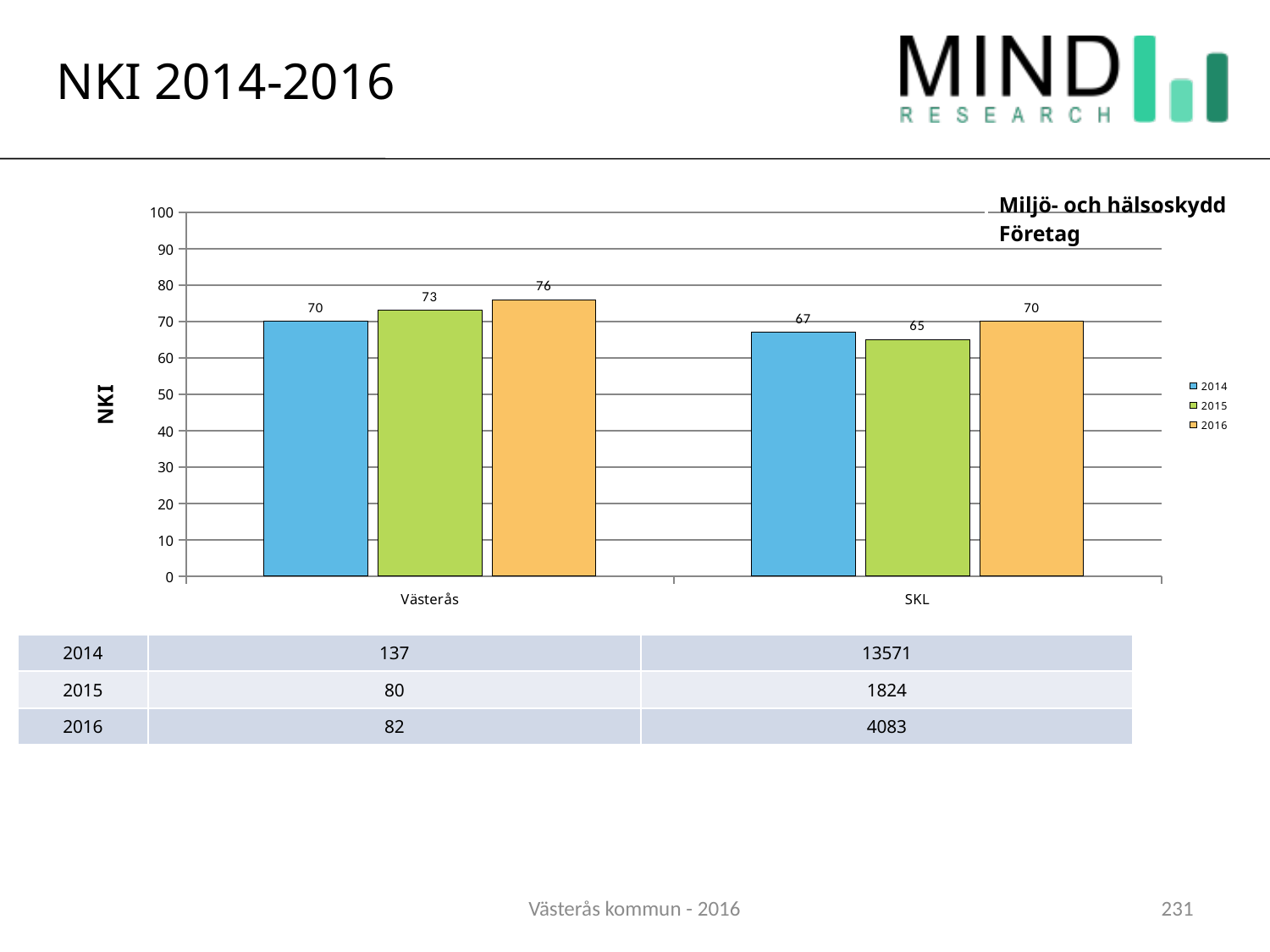
What is the label on the y axis of the chart? NKI Which is larger, the 2015 NKI value for Västerås or for SKL? Västerås What is the NKI value for SKL in 2015? 65 What is the NKI value for Västerås in 2016? 76 What is the difference between the 2016 NKI values for Västerås and SKL? 6 Do the NKI values for Västerås rise or fall from 2014 to 2016? Rise How many categories are shown on the x axis? 2 Which year has the highest NKI value for Västerås? 2016 How many series does the legend list? 3 What is the NKI value for Västerås in 2014? 70 What kind of chart is shown on the slide? Bar chart Which year has the lowest NKI value for SKL? 2015